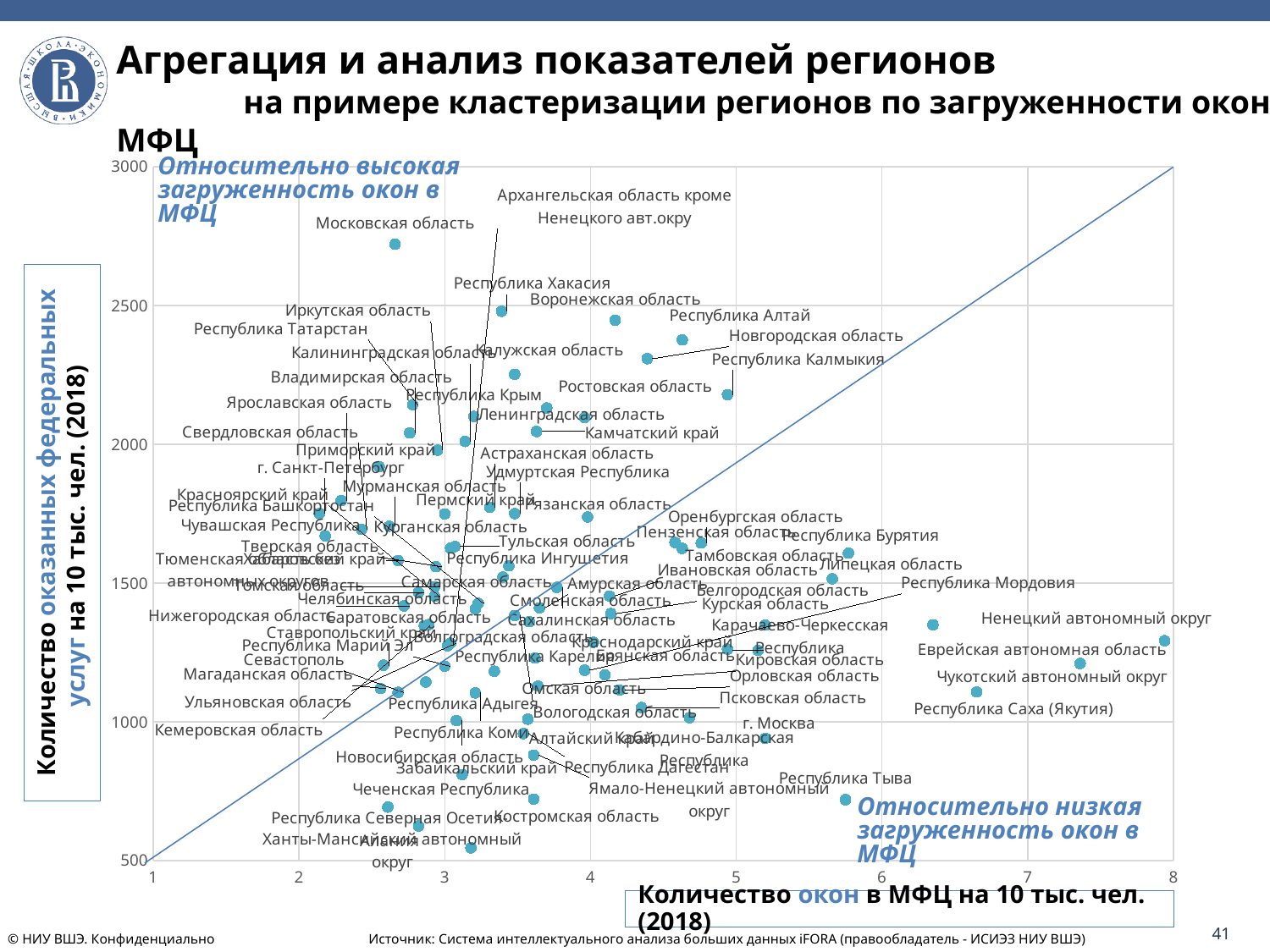
Is the horizontal-axis value for Республика Саха (Якутия) greater or less than 6? greater Is the vertical-axis value for Московская область greater or less than 2500? greater What annotation is placed in the top-left corner of the chart? Относительно высокая загруженность окон в МФЦ What is the title of the horizontal axis? Количество окон в МФЦ на 10 тыс. чел. (2018) Which region has a higher vertical-axis value: Московская область or Республика Тыва? Московская область Which region has the lowest value on the vertical axis? Ханты-Мансийский автономный округ Is the vertical-axis value for Ростовская область greater or less than 2000? greater Which region is plotted furthest to the right on the horizontal axis (number of MFC windows per 10 thousand people)? Еврейская автономная область What kind of chart is shown on the slide? Scatter chart Which region has the highest value on the vertical axis (number of federal services provided per 10 thousand people)? Московская область